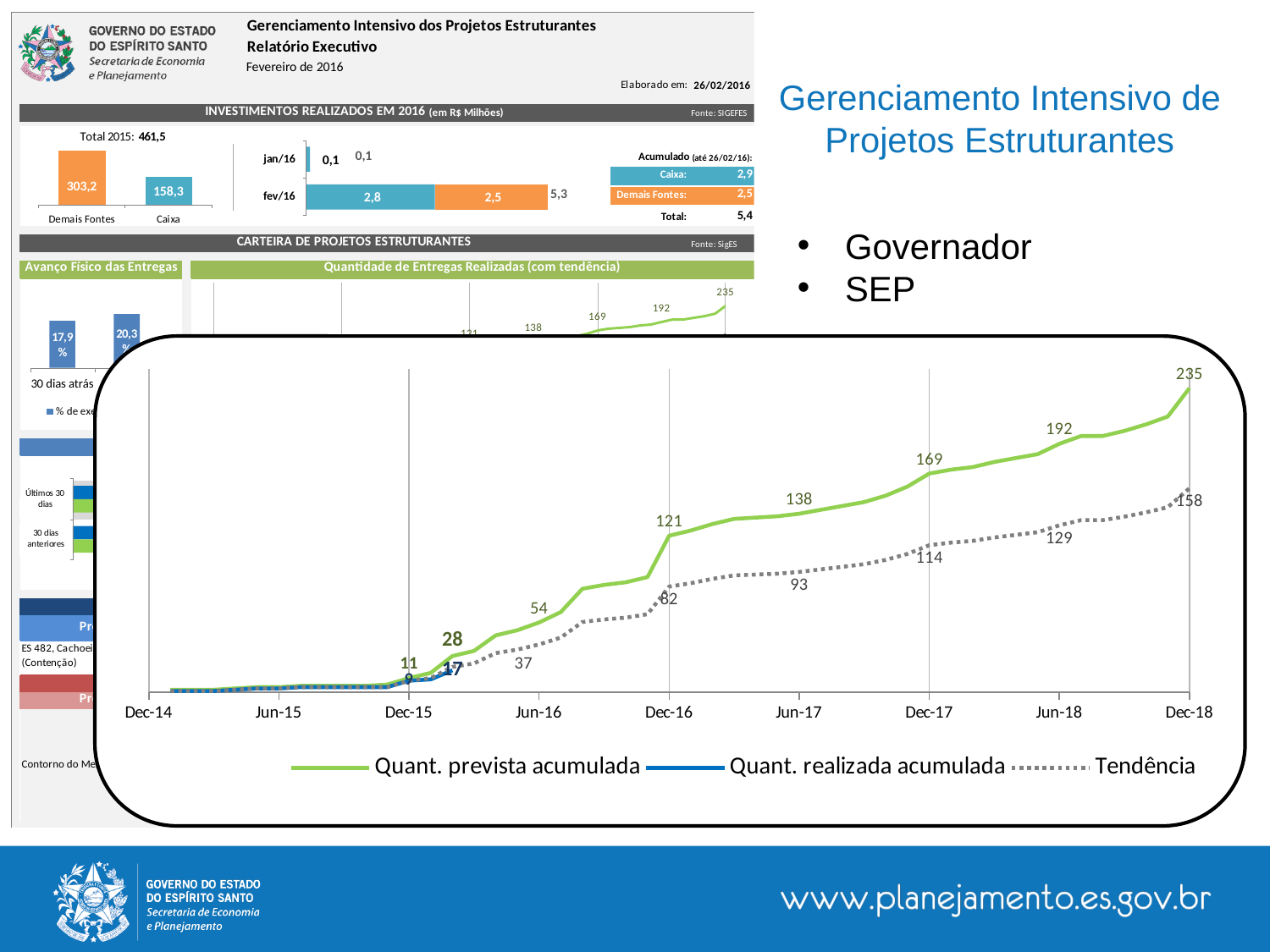
In the large line chart, what is the last labelled value of the 'Quant. prevista acumulada' series, at Dec-18? 235 In the small 'INVESTIMENTOS REALIZADOS EM 2016' bar chart, what is the value for 'Demais Fontes'? 303,2 In the small 'INVESTIMENTOS REALIZADOS EM 2016' bar chart, what is the difference between 'Demais Fontes' (303,2) and 'Caixa' (158,3)? 144,9 In the small stacked bar chart for jan/16 and fev/16, what is the total labelled for the fev/16 bar? 5,3 In the large line chart, what value is labelled on the 'Quant. prevista acumulada' series at Dec-16? 121 In the large line chart, does the 'Quant. prevista acumulada' series rise or fall from Dec-14 to Dec-18? rise In the large line chart, what value is labelled on the 'Tendência' series at Dec-17? 114 In the large line chart, what is the difference between the Dec-18 values of 'Quant. prevista acumulada' (235) and 'Tendência' (158)? 77 What kind of chart is the large chart in the foreground showing 'Quant. prevista acumulada', 'Quant. realizada acumulada' and 'Tendência'? line chart In the large line chart at Dec-17, which is larger: 'Quant. prevista acumulada' or 'Tendência'? Quant. prevista acumulada In the large line chart, what is the last labelled value of the 'Tendência' series, at Dec-18? 158 How many series does the legend of the large line chart list? 3